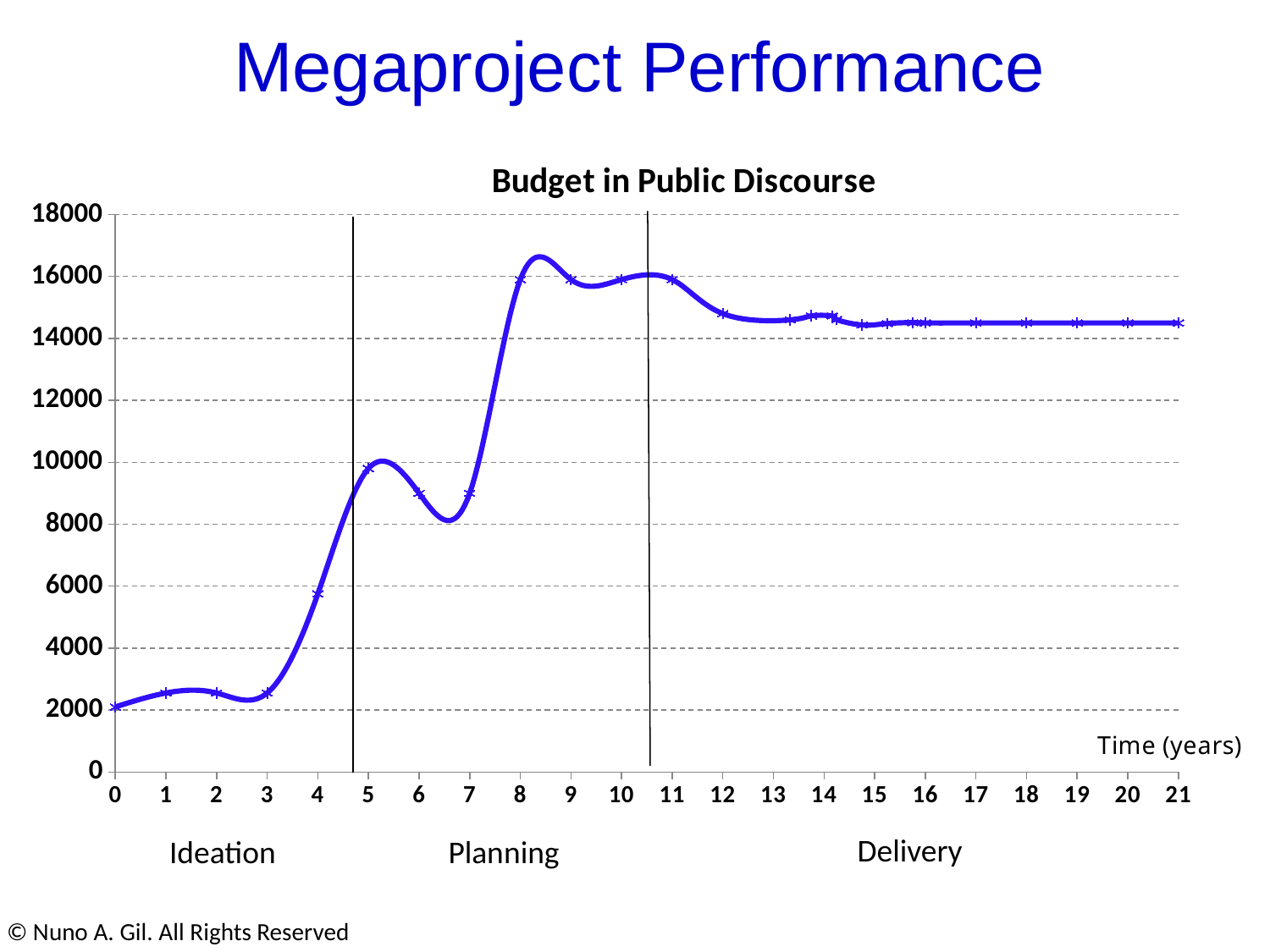
What kind of chart is shown on the slide? line chart Is the value at year 8 greater or less than 14000? greater Which is larger, the value at year 5 or the value at year 6? year 5 What are the three project phases labelled beneath the x axis? Ideation, Planning, Delivery What is the title of the chart? Budget in Public Discourse At which year is the plotted value lowest? 0 Is the value at year 12 greater or less than 16000? less Is the value at year 3 greater or less than 4000? less Which is larger, the value at year 8 or the value at year 4? year 8 Does the value rise or fall between year 3 and year 8? rise